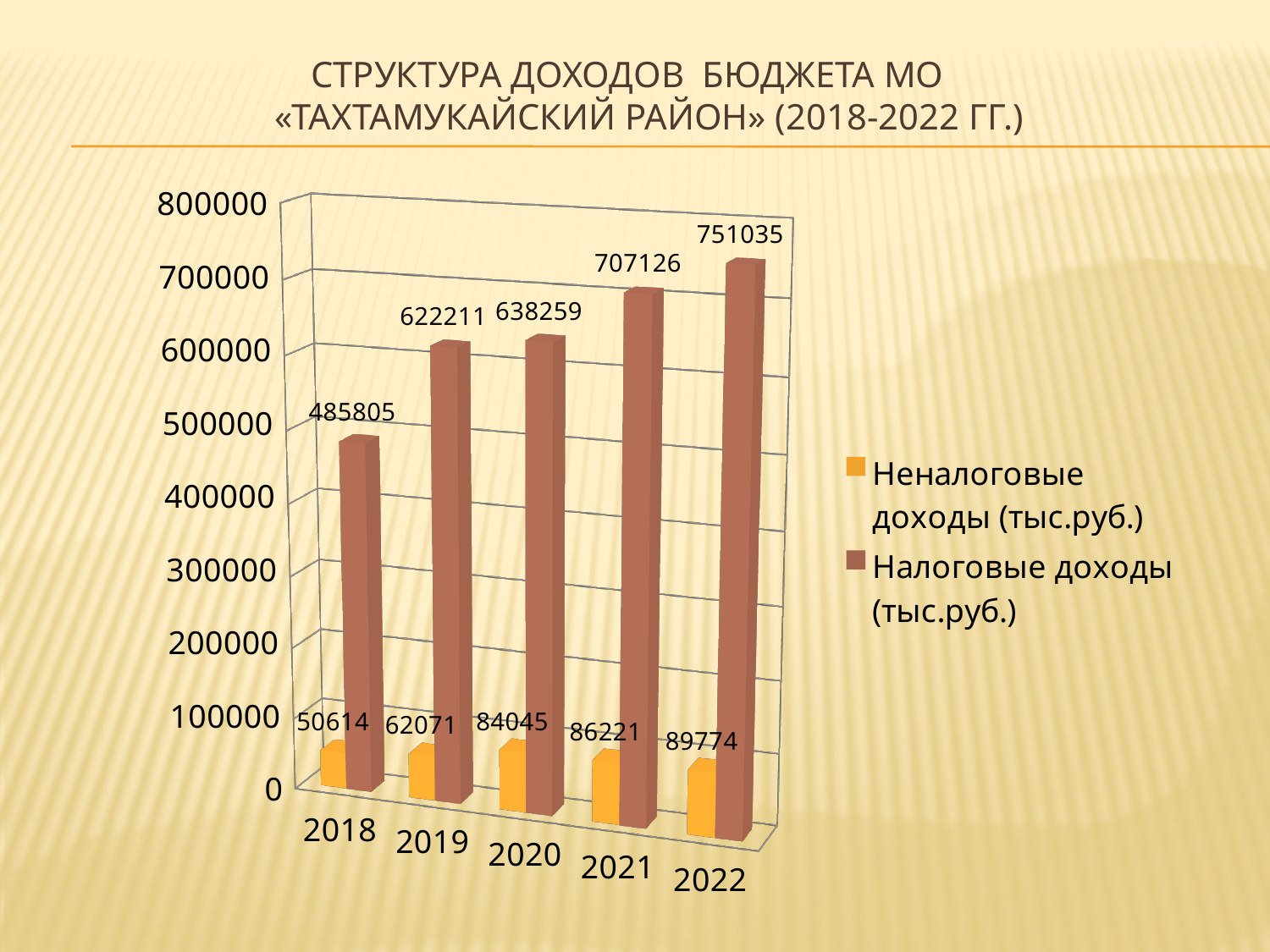
Which is larger: Налоговые доходы (тыс.руб.) in 2019 or in 2021? 2021 What kind of chart is shown on the slide? bar chart What is the value of Неналоговые доходы (тыс.руб.) for 2018? 50614 What is the difference between Налоговые доходы (тыс.руб.) in 2022 and in 2018? 265230 What is the value of Налоговые доходы (тыс.руб.) for 2020? 638259 What is the value of Налоговые доходы (тыс.руб.) for 2022? 751035 Which year has the highest value of Налоговые доходы (тыс.руб.)? 2022 Do the values of Налоговые доходы (тыс.руб.) rise or fall from 2018 to 2022? rise Which year has the lowest value of Неналоговые доходы (тыс.руб.)? 2018 Is the value of Налоговые доходы (тыс.руб.) for 2018 greater or less than 500000? less How many series does the legend list? 2 How many years are shown on the x axis of the chart? 5